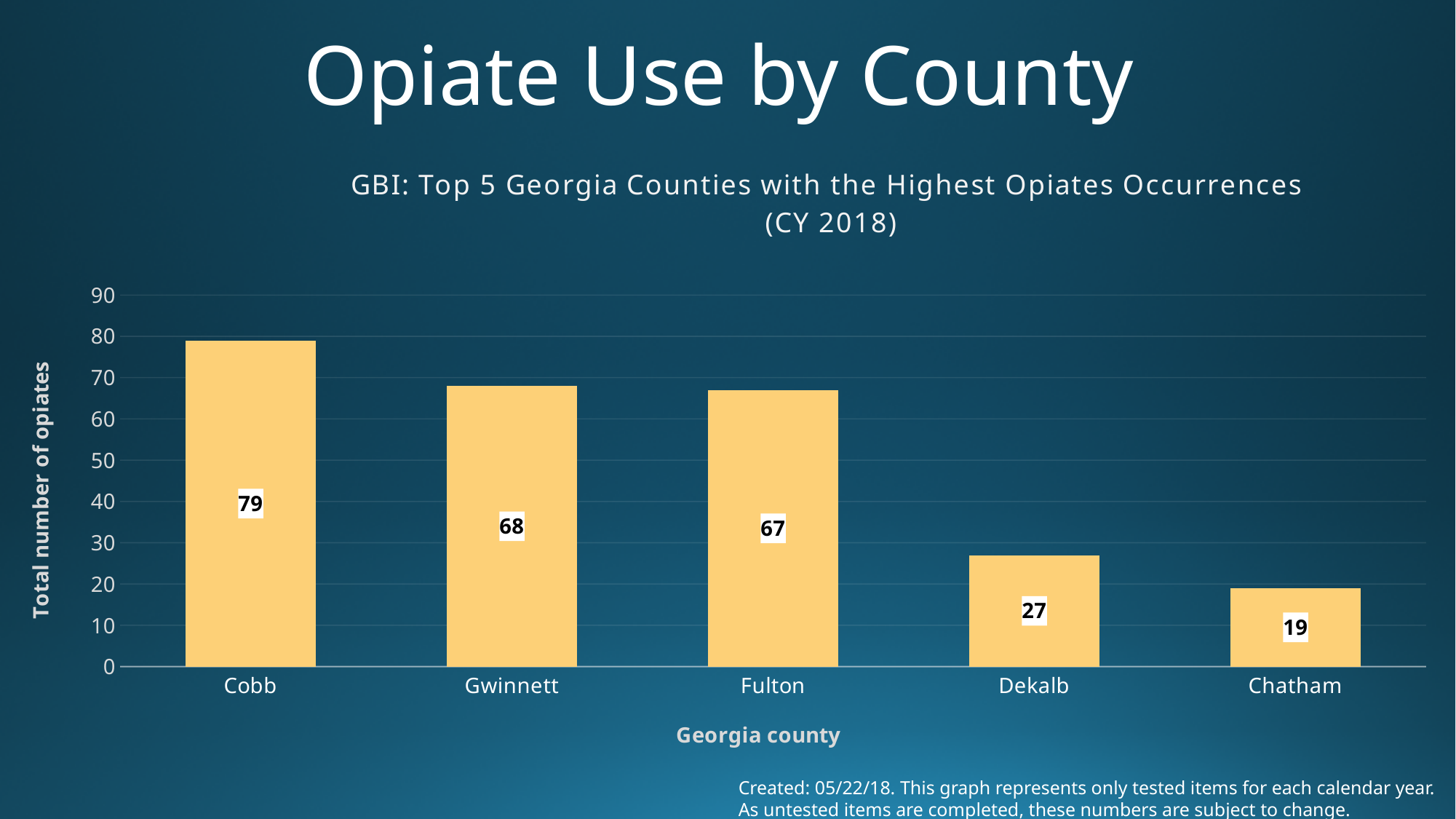
How many counties are shown on the chart? 5 What is the total number of opiates for Dekalb county? 27 What is the difference between the values for Cobb and Gwinnett? 11 What is the total number of opiates for Chatham county? 19 What is the total number of opiates for Cobb county? 79 What is the difference between the values for Dekalb and Chatham? 8 What kind of chart is shown on the slide? Bar chart Which county has the lowest total number of opiates? Chatham Which county has a larger value, Fulton or Dekalb? Fulton Is the value for Gwinnett greater or less than 60? greater Which county has the highest total number of opiates? Cobb What is the label of the vertical axis? Total number of opiates